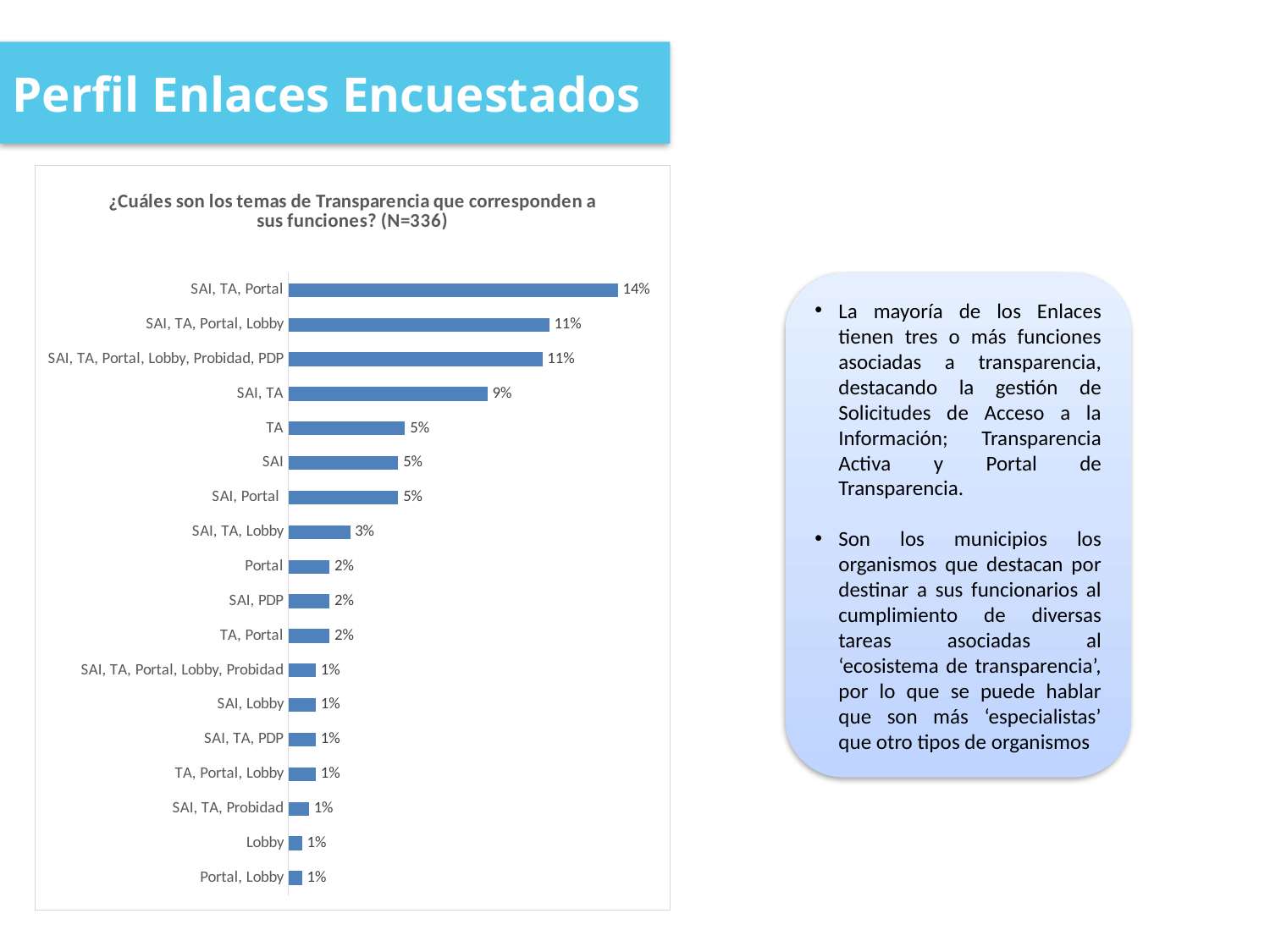
What kind of chart is shown on the slide? Bar chart How many categories are shown in the chart? 18 What is the difference between the values for "SAI, TA, Portal" and "SAI, TA, Portal, Lobby"? 3 percentage points What is the value for "SAI, TA"? 9% What is the value for "SAI, TA, Portal"? 14% What is the value for "TA, Portal"? 2% Which category has the highest value? SAI, TA, Portal What is the value for "SAI, TA, Lobby"? 3% What is the difference between the values for "SAI, TA, Portal" and "SAI, TA"? 5 percentage points What is the sample size (N) stated in the chart title? 336 Which is larger, the value for "SAI, TA" or the value for "TA"? SAI, TA Which is larger, the value for "Portal" or the value for "SAI, TA, Lobby"? SAI, TA, Lobby